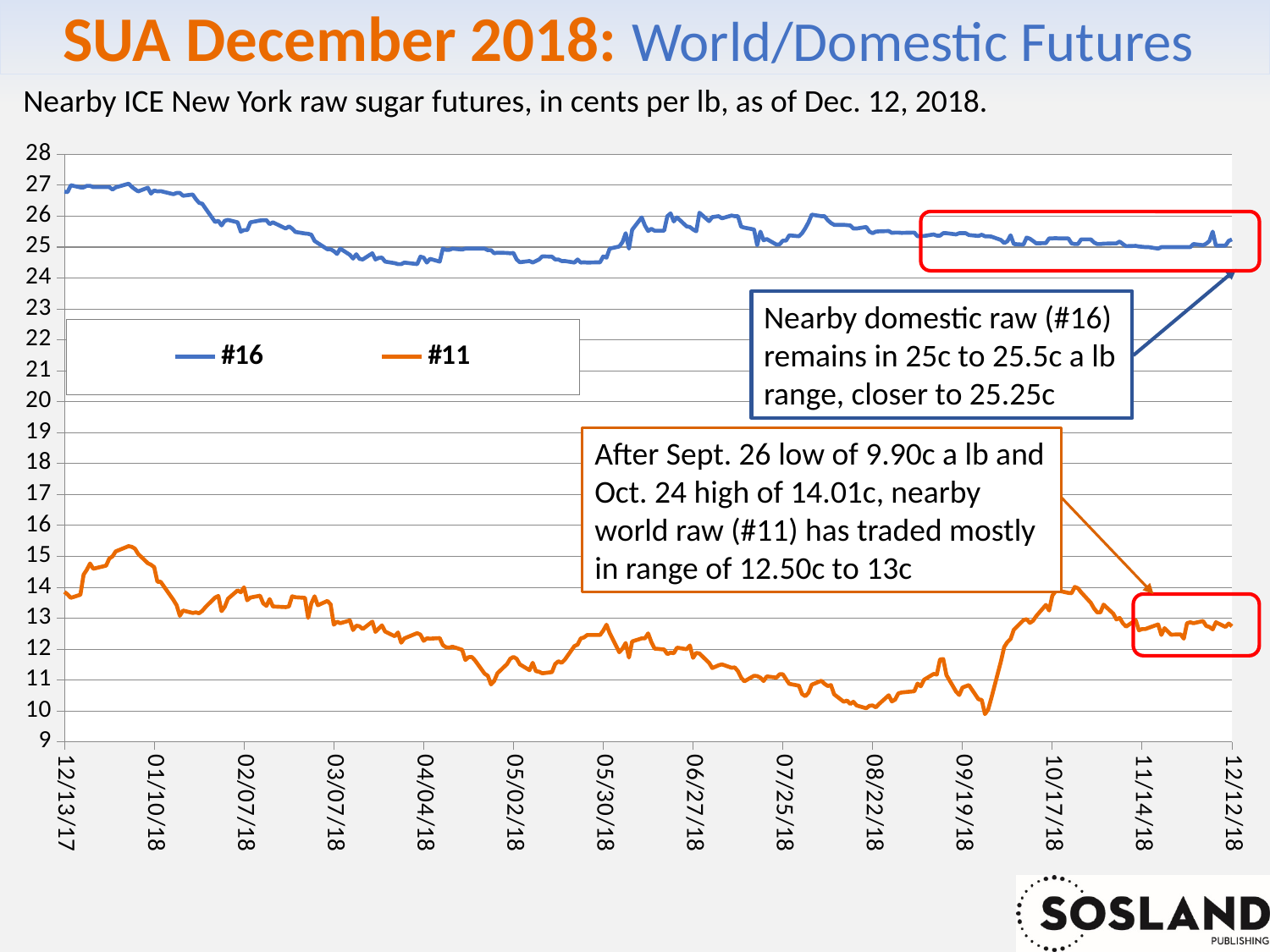
Which series is drawn in orange? #11 According to the annotation, what was the Sept. 26 low for nearby world raw (#11)? 9.90c a lb Is the value of #11 at 08/22/18 greater or less than 11? less Which series has the higher values throughout the chart, #16 or #11? #16 How many series does the legend list? 2 Does the #16 series end higher or lower at 12/12/18 than it started at 12/13/17? Lower Is the value of #16 at 12/13/17 greater or less than 26? greater Is the value of #11 at 12/13/17 greater or less than 13? greater According to the annotation, what was the Oct. 24 high for nearby world raw (#11)? 14.01c What are the two series named in the legend? #16 and #11 What kind of chart is shown on the slide? Line chart